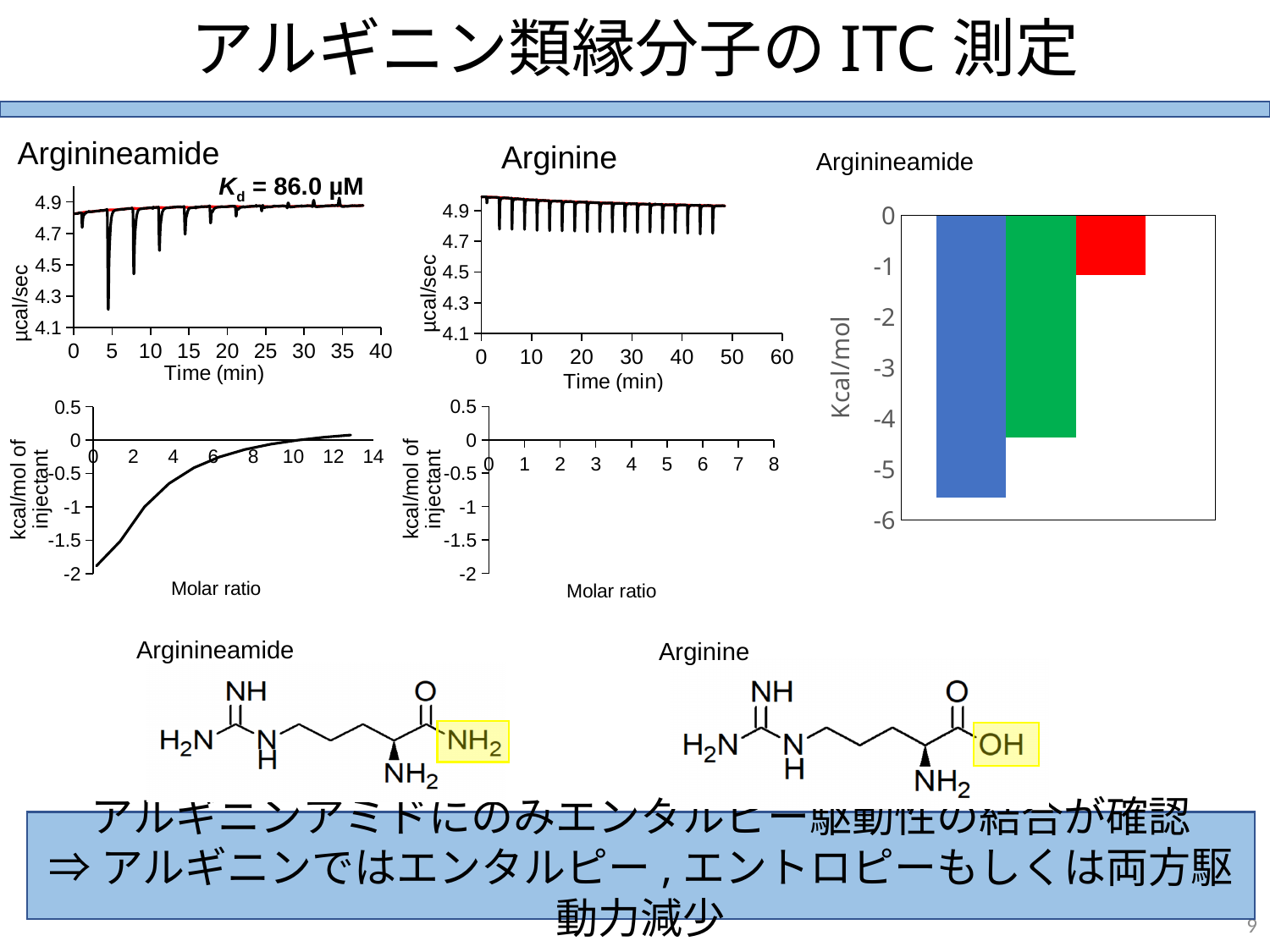
What kind of chart is the Arginineamide chart on the right side of the slide (with the Kcal/mol axis)? bar chart In the Arginineamide bar chart on the right, is the value of the red bar greater or less than -2? greater In the Arginineamide bar chart on the right, is the value of the green bar greater or less than -5? greater What is the x-axis label of the Arginine µcal/sec chart at the top middle of the slide? Time (min) What Kd value is printed on the Arginineamide µcal/sec vs Time chart at the top left? Kd = 86.0 µM In the Arginineamide bar chart on the right, which bar extends further below zero, the green bar or the red bar? the green bar In the Arginineamide bar chart on the right, which bar has the value closest to zero? the red bar In the Arginineamide bar chart on the right, is the value of the blue bar greater or less than -5? less In the Arginineamide bar chart on the right, what is the y-axis label? Kcal/mol In the Arginineamide bar chart on the right, which bar has the lowest (most negative) value? the blue bar In the Arginineamide kcal/mol of injectant vs Molar ratio chart at the lower left, does the curve rise or fall as the molar ratio increases? rise How many bars are plotted in the Arginineamide bar chart on the right side of the slide? 3